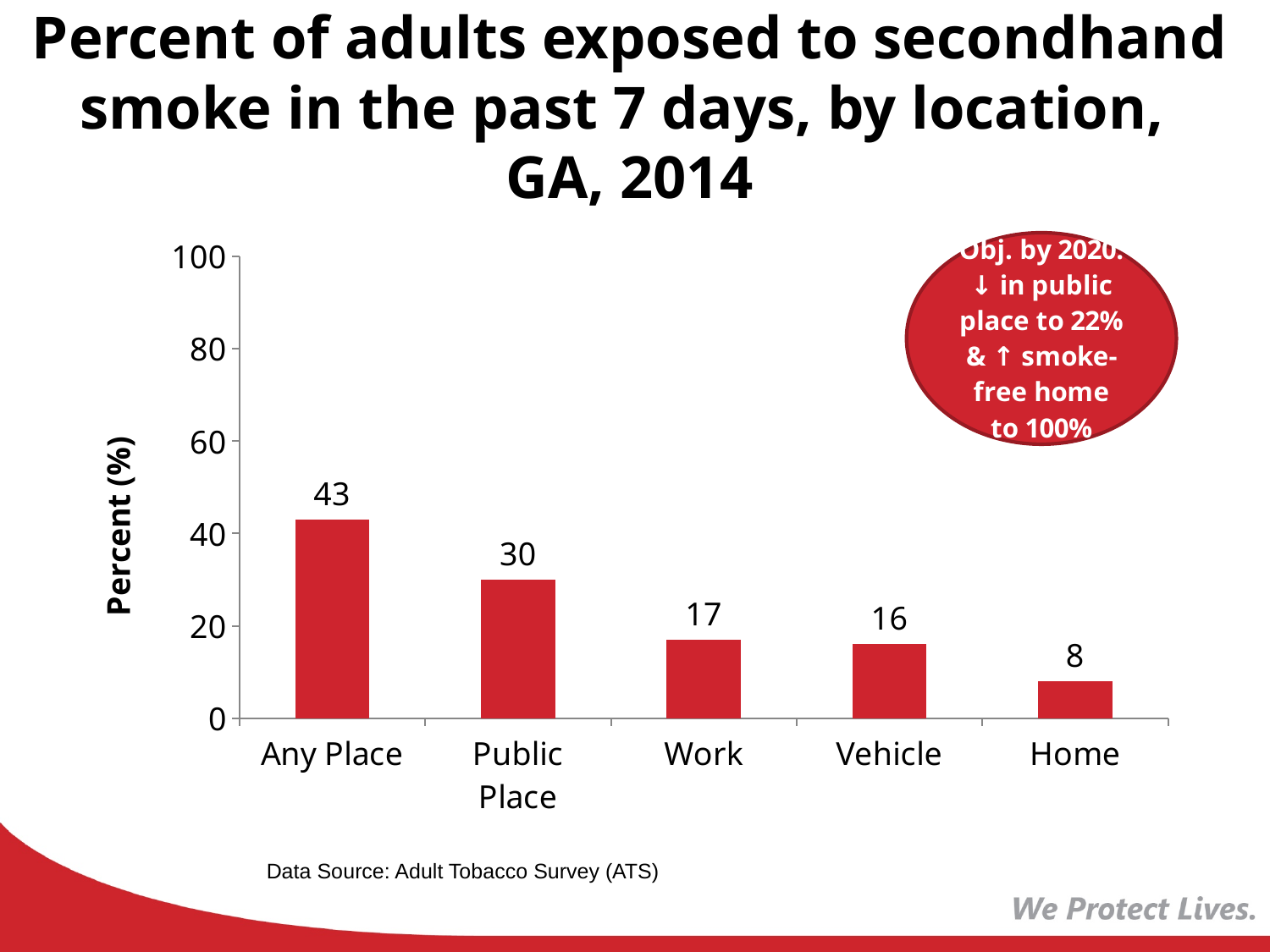
What is the value shown for Public Place? 30 How many locations are shown on the chart? 5 What is the label of the y axis? Percent (%) Is the value for Any Place greater or less than 40? greater What is the difference between the values for Any Place and Public Place? 13 Which location has the lowest percent of adults exposed to secondhand smoke? Home What is the difference between the values for Work and Home? 9 What is the value shown for Home? 8 Which location has the highest percent of adults exposed to secondhand smoke? Any Place What percent of adults were exposed to secondhand smoke in Any Place? 43 What kind of chart is shown on the slide? Bar chart Which is larger, the value for Public Place or the value for Vehicle? Public Place